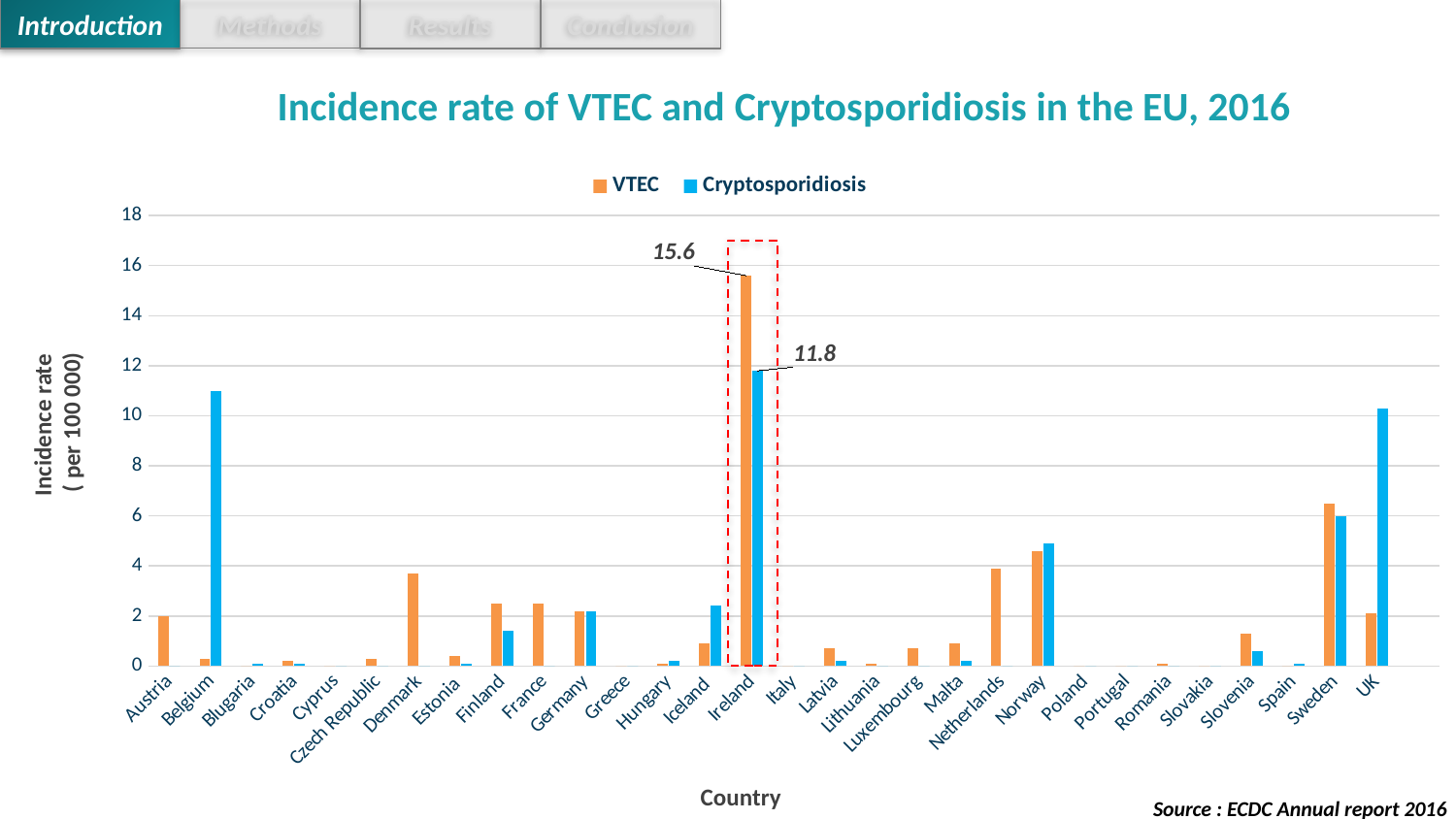
For Belgium, which is larger: the VTEC or the Cryptosporidiosis incidence rate? Cryptosporidiosis How many countries are shown on the x axis of the chart? 30 Which country has the highest VTEC incidence rate? Ireland What is the difference between the VTEC and Cryptosporidiosis incidence rates for Ireland? 3.8 What is the VTEC incidence rate for Ireland? 15.6 What is the Cryptosporidiosis incidence rate for Ireland? 11.8 For Finland, which is larger: the VTEC or the Cryptosporidiosis incidence rate? VTEC What type of chart is shown on the slide? Bar chart Is the Cryptosporidiosis incidence rate for Belgium greater or less than 10? greater How many series does the chart legend list? 2 Is the VTEC incidence rate for Sweden greater or less than 6? greater Is the VTEC incidence rate for Denmark greater or less than 2? greater